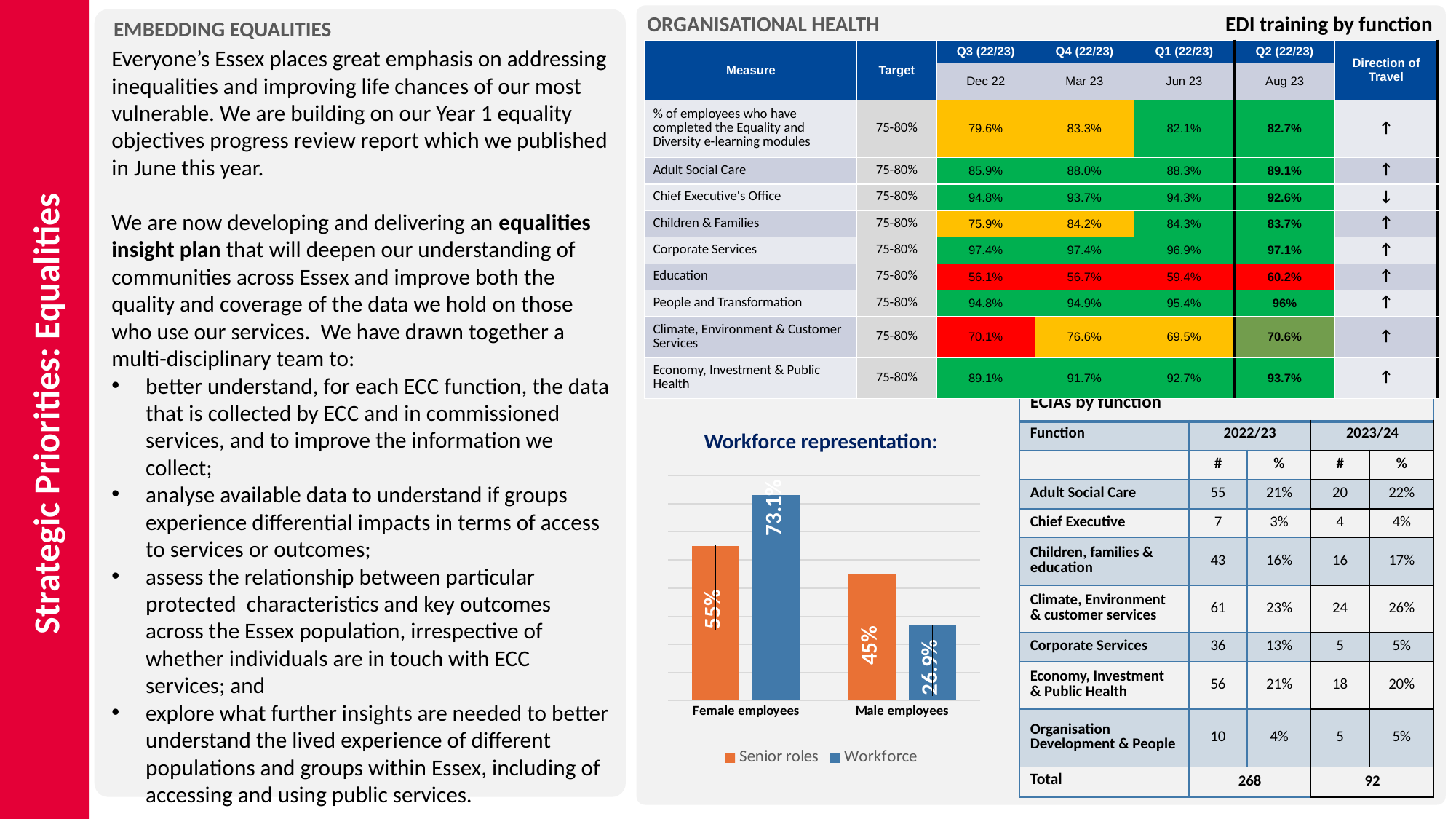
In the Workforce representation chart, for Male employees, which is larger: the Senior roles value or the Workforce value? Senior roles In the Workforce representation chart, which category has the lowest Senior roles value? Male employees In the Workforce representation chart, what is the Workforce value for Male employees? 26.9% In the Workforce representation chart, what is the difference between the Senior roles values for Female employees and Male employees? 10% In the Workforce representation chart, what is the difference between the Workforce values for Female employees and Male employees? 46.2% In the Workforce representation chart, what is the Senior roles value for Female employees? 55% In the Workforce representation chart, for Female employees, which is larger: the Senior roles value or the Workforce value? Workforce In the Workforce representation chart, what is the Workforce value for Female employees? 73.1% In the Workforce representation chart, which category has the highest Workforce value? Female employees What kind of chart is the Workforce representation chart? Bar chart In the Workforce representation chart, what is the Senior roles value for Male employees? 45% How many series does the legend of the Workforce representation chart list? 2